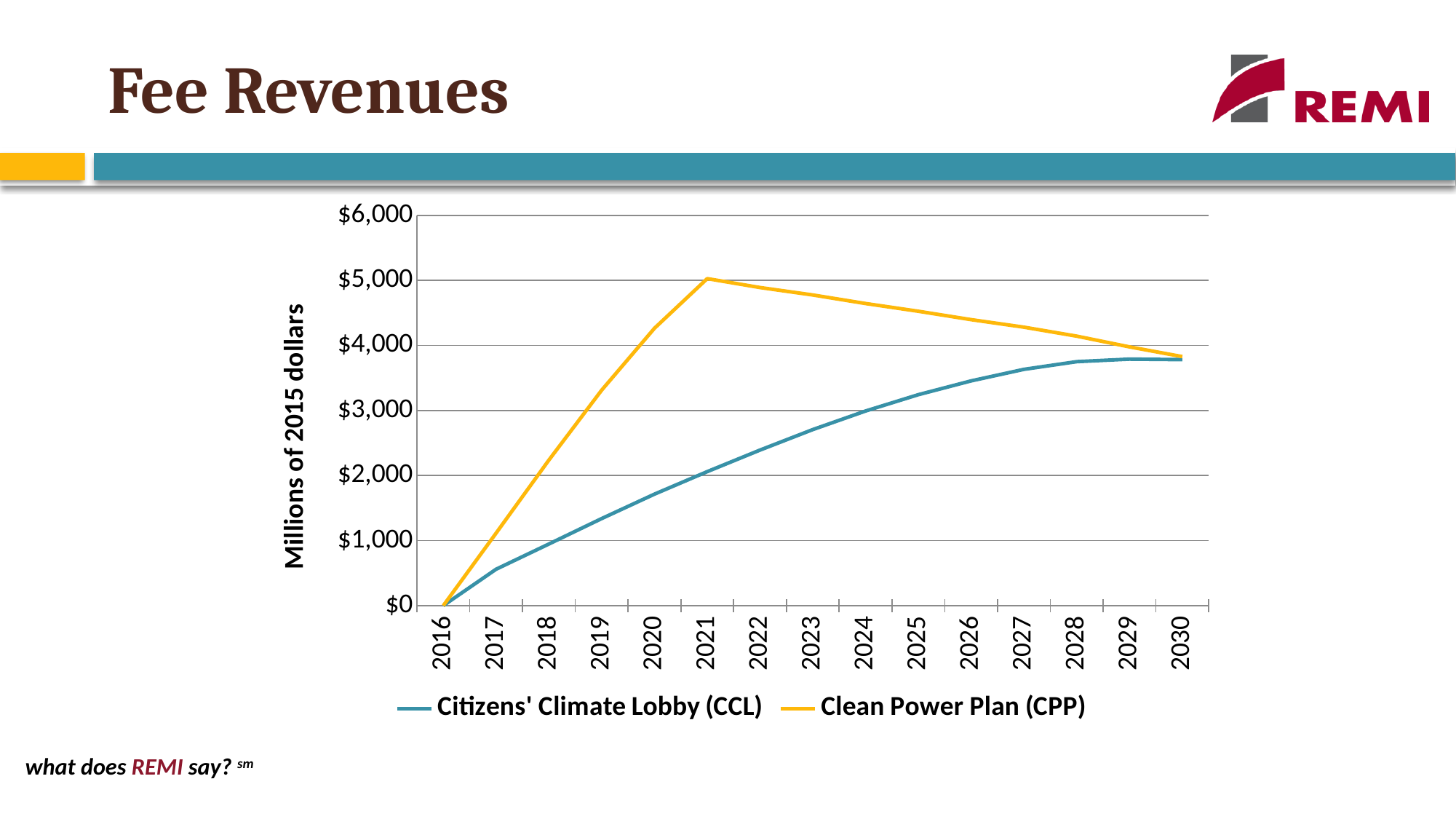
How many series does the legend list? 2 Is the value for Citizens' Climate Lobby (CCL) in 2030 greater or less than $4,000? less What is the title of the slide containing the chart? Fee Revenues In which year does the Clean Power Plan (CPP) series reach its highest value? 2021 What kind of chart is shown on the slide? line chart Is the value for Clean Power Plan (CPP) in 2025 greater or less than $4,000? greater In 2021, which series has the larger value, Citizens' Climate Lobby (CCL) or Clean Power Plan (CPP)? Clean Power Plan (CPP) Does the Citizens' Climate Lobby (CCL) series rise or fall from 2016 to 2030? rise How many years are shown along the x axis? 15 What is the label on the vertical axis? Millions of 2015 dollars Is the value for Citizens' Climate Lobby (CCL) in 2017 greater or less than $1,000? less